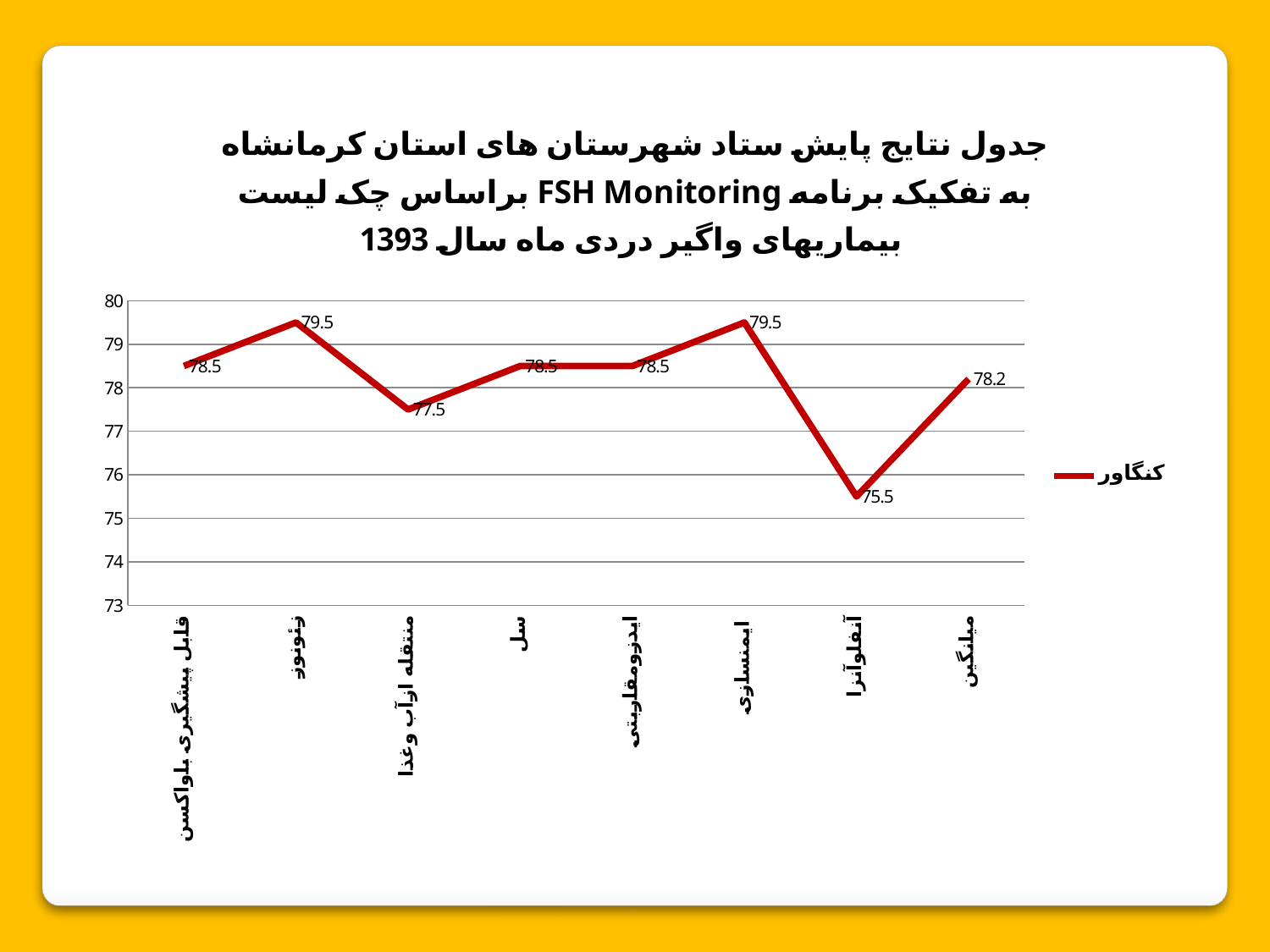
Which is larger, the value for سل or the value for منتقله از آب و غذا? سل What is the value for منتقله از آب و غذا? 77.5 What type of chart is shown on the slide? line chart Is the value for آنفلوآنزا greater or less than 76? less How many series does the legend list? 1 What is the difference between the values for ایمنسازی and آنفلوآنزا? 4 How many categories are plotted on the x axis? 8 What is the value for زئونوز? 79.5 What is the name of the series shown in the legend? کنگاور Which category has the lowest value? آنفلوآنزا What is the value for آنفلوآنزا? 75.5 What is the value for میانگین? 78.2